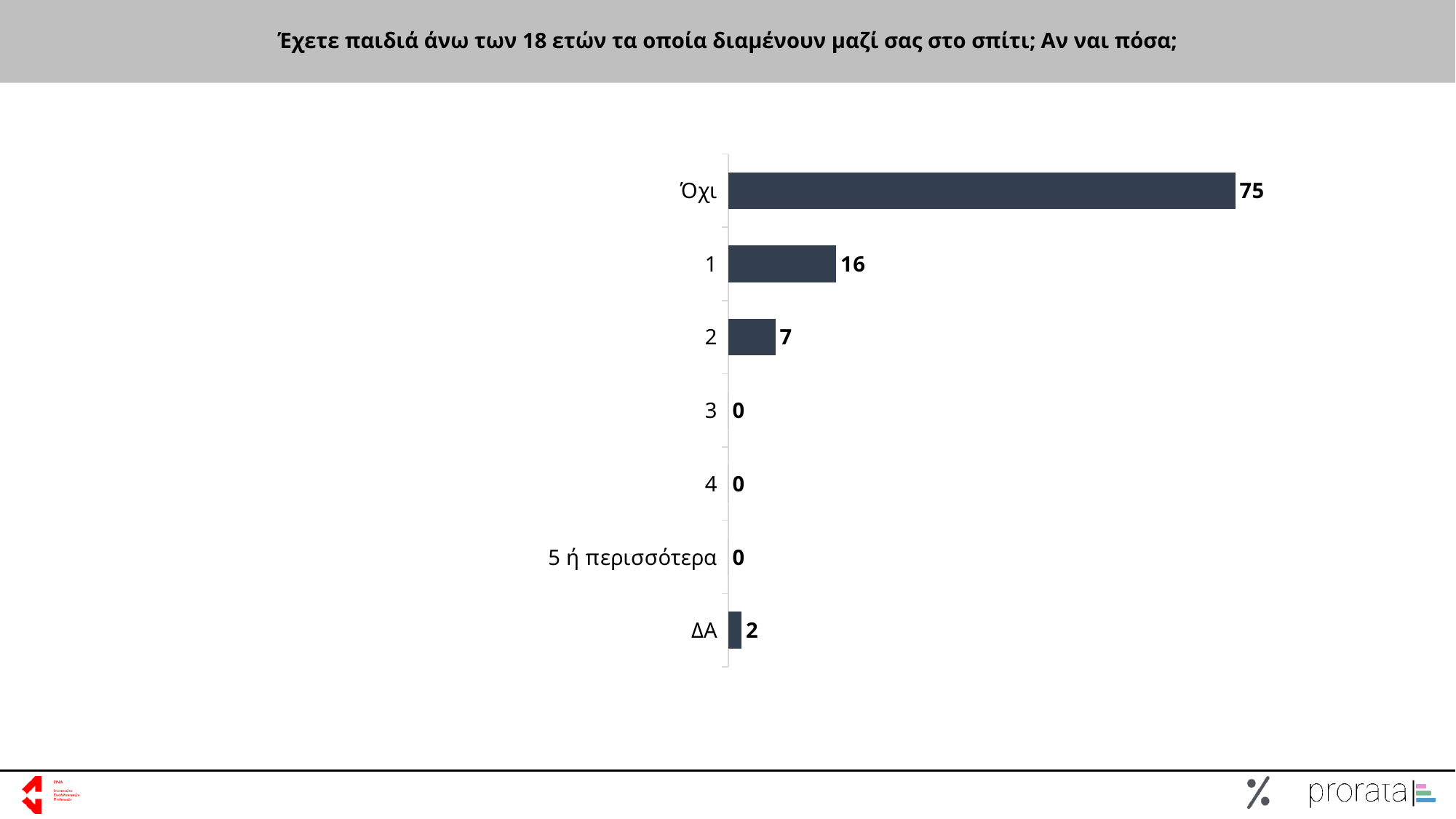
What is the value for "ΔΑ"? 2 How many categories have a value of 0? 3 How many categories are shown on the chart? 7 What is the value for "5 ή περισσότερα"? 0 What kind of chart is shown on the slide? Bar chart What is the difference between the values for "Όχι" and "1"? 59 What is the difference between the values for "1" and "2"? 9 Which is larger, the value for "2" or the value for "ΔΑ"? 2 Which category has the highest value? Όχι What is the value for "Όχι"? 75 What is the value for the category "1"? 16 What is the value for the category "2"? 7